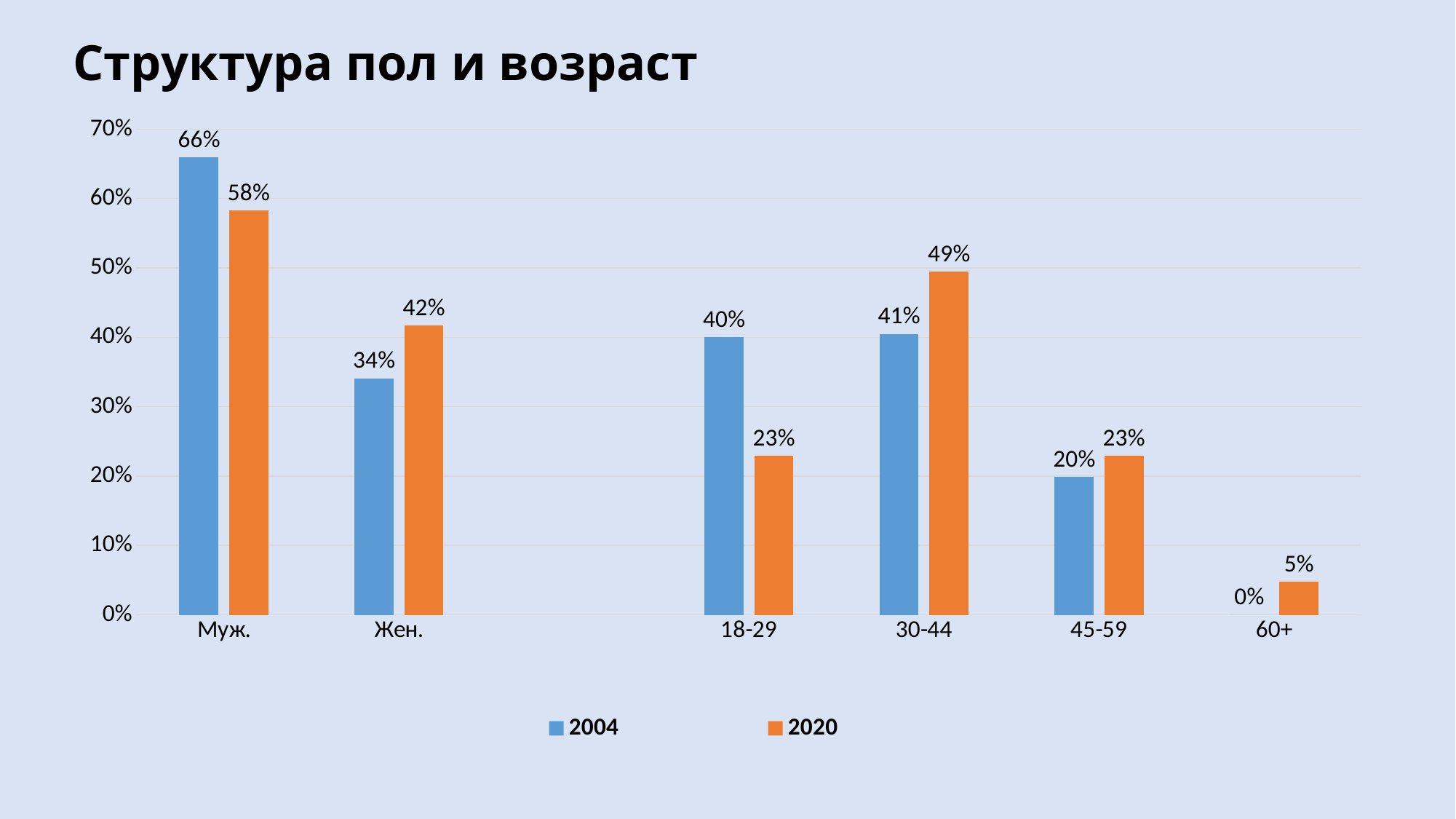
What is the value for Жен. in the 2020 series? 42% Which category has the highest value in the 2004 series? Муж. Which is larger for 45-59: the 2004 value or the 2020 value? 2020 How many categories are shown on the x axis? 6 How many series does the legend list? 2 What is the title of the chart? Структура пол и возраст What is the value for 60+ in the 2004 series? 0% What is the value for 30-44 in the 2020 series? 49% What is the value for Муж. in the 2004 series? 66% Which category has the lowest value in the 2020 series? 60+ What is the difference between the 2004 and 2020 values for 18-29? 17% What kind of chart is shown on the slide? Bar chart